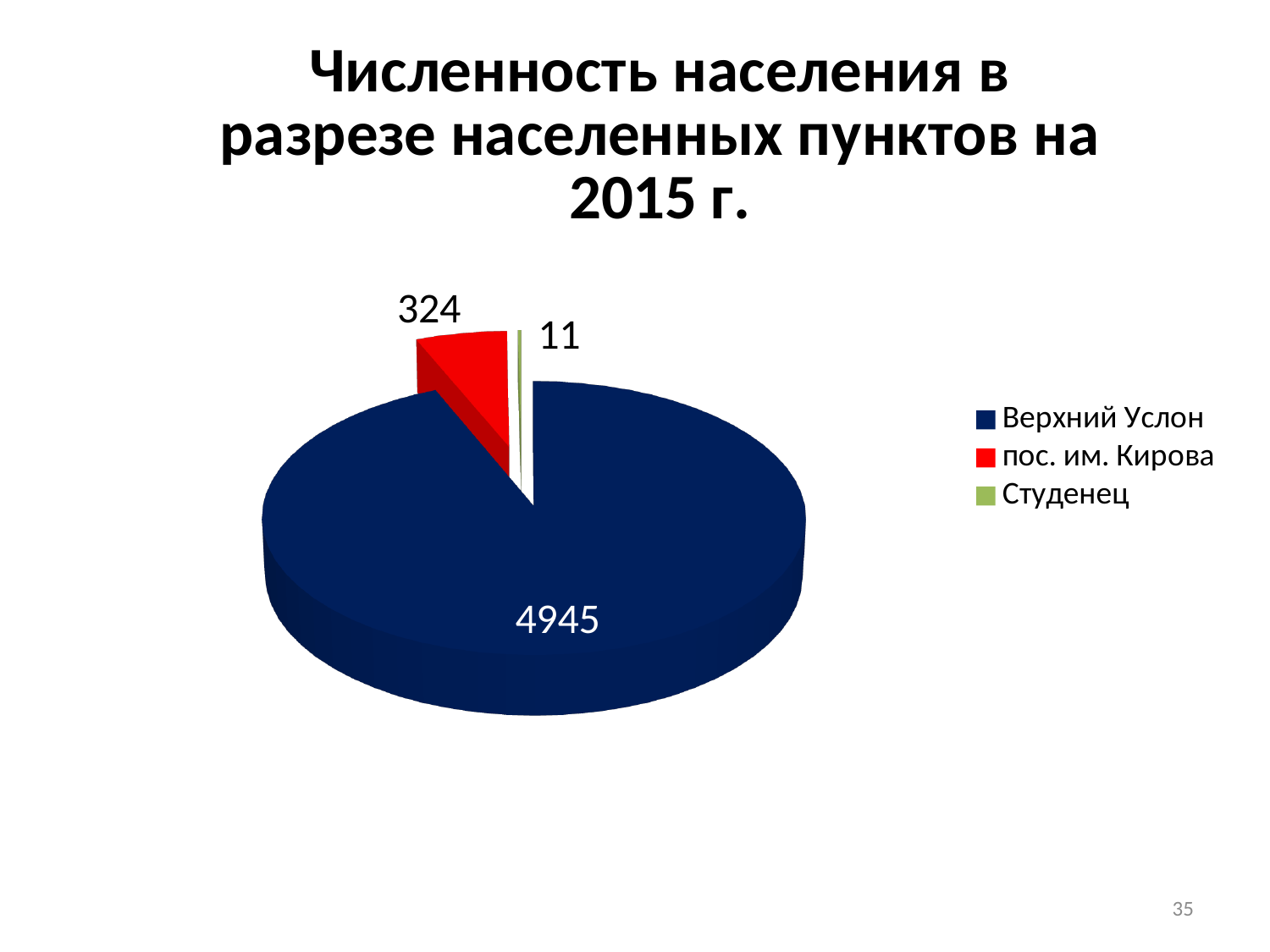
Which colour represents пос. им. Кирова in the chart? Red Which has a larger population, пос. им. Кирова or Студенец? пос. им. Кирова What is the difference between the population of Верхний Услон and пос. им. Кирова? 4621 What is the population value shown for Верхний Услон? 4945 How many settlements are shown in the pie chart? 3 What is the total population across all three settlements in the chart? 5280 Which settlement has the largest population in the chart? Верхний Услон What is the difference between the population of пос. им. Кирова and Студенец? 313 What is the population value shown for пос. им. Кирова? 324 Which settlement has the smallest population in the chart? Студенец What is the population value shown for Студенец? 11 What type of chart is shown on the slide? Pie chart